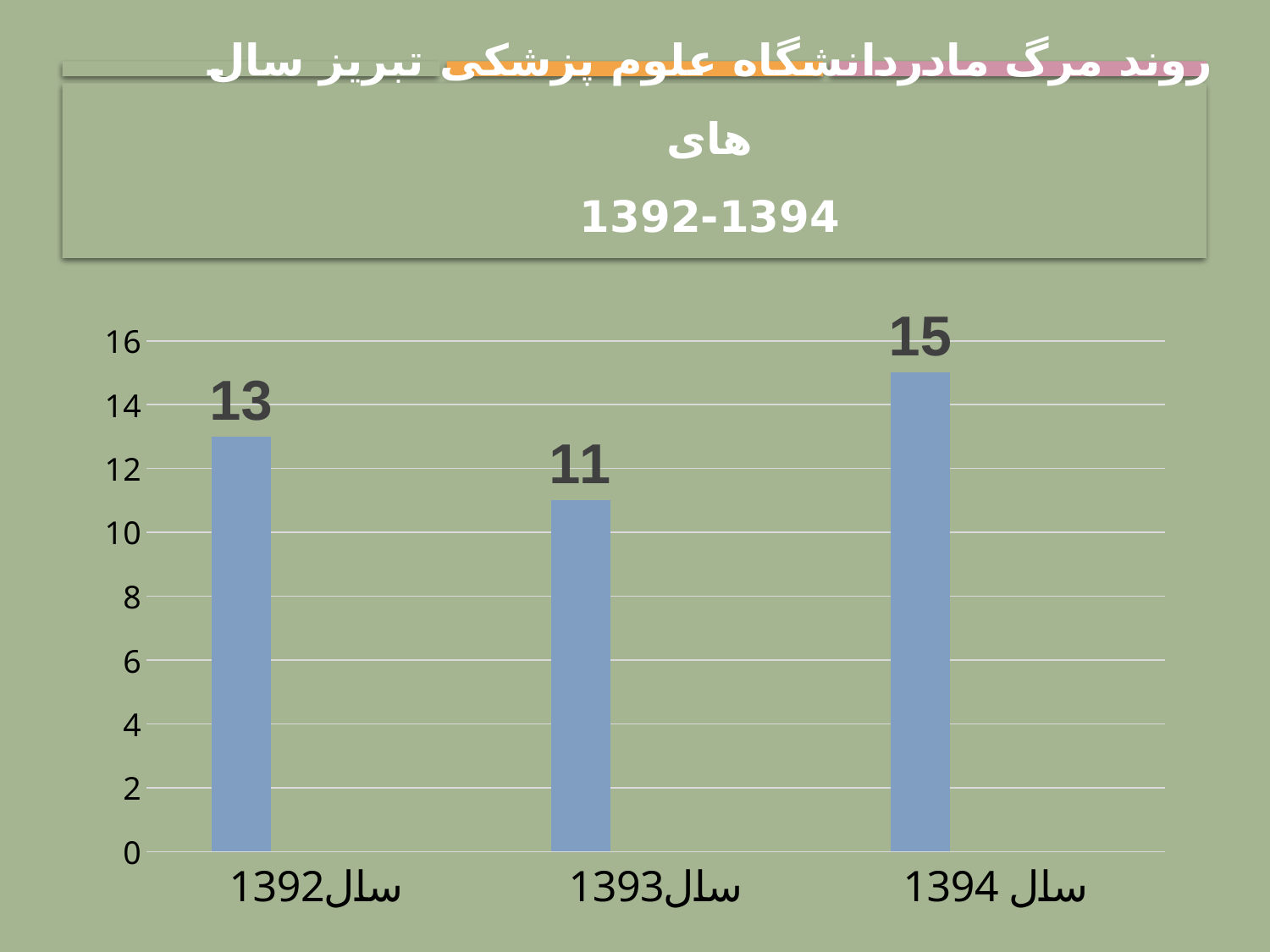
What is the value for سال1392? 13 Which is larger, the value for سال1392 or the value for سال 1394? سال 1394 Is the value for سال1393 greater or less than 12? less Which year has the highest value? سال 1394 What kind of chart is shown on the slide? bar chart What is the highest value shown on the y axis? 16 Which year has the lowest value? سال1393 What is the value for سال1393? 11 What is the difference between the values for سال 1394 and سال1393? 4 What is the difference between the values for سال1392 and سال1393? 2 How many years are shown on the x axis? 3 What is the value for سال 1394? 15